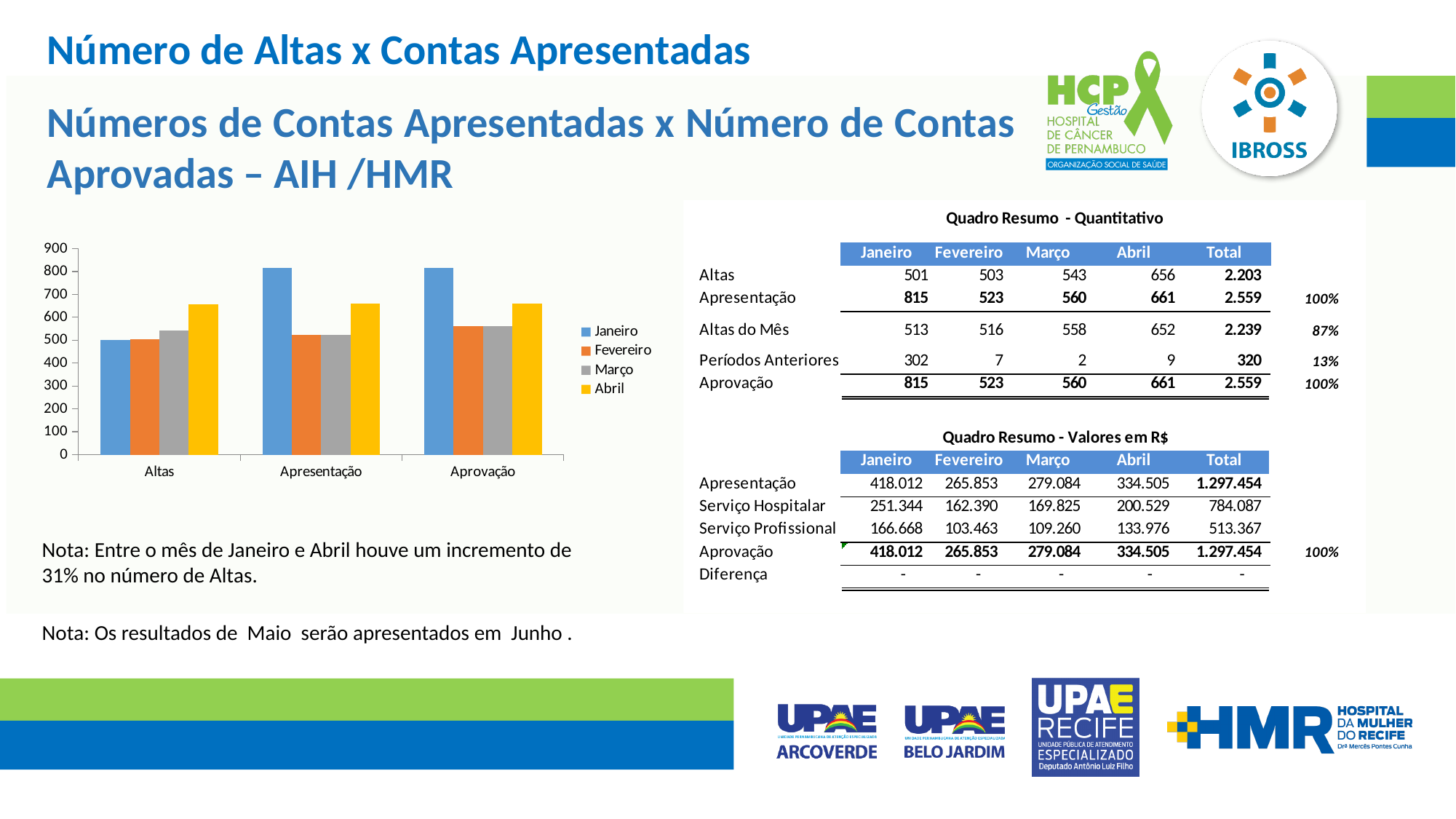
Which month has the highest bar in the Apresentação category? Janeiro Is the Janeiro bar for Apresentação greater or less than 700? greater How many categories are shown on the x axis of the chart? 3 Which month has the highest bar in the Altas category? Abril Which is larger in the Altas category, the Janeiro bar or the Abril bar? Abril What colour represents Abril in the chart legend? yellow Do the Altas bars rise or fall from Janeiro to Abril? rise What kind of chart is shown on the slide? bar chart Is the Abril bar for Altas greater or less than 600? greater Is the Fevereiro bar for Apresentação greater or less than 600? less How many series does the chart legend list? 4